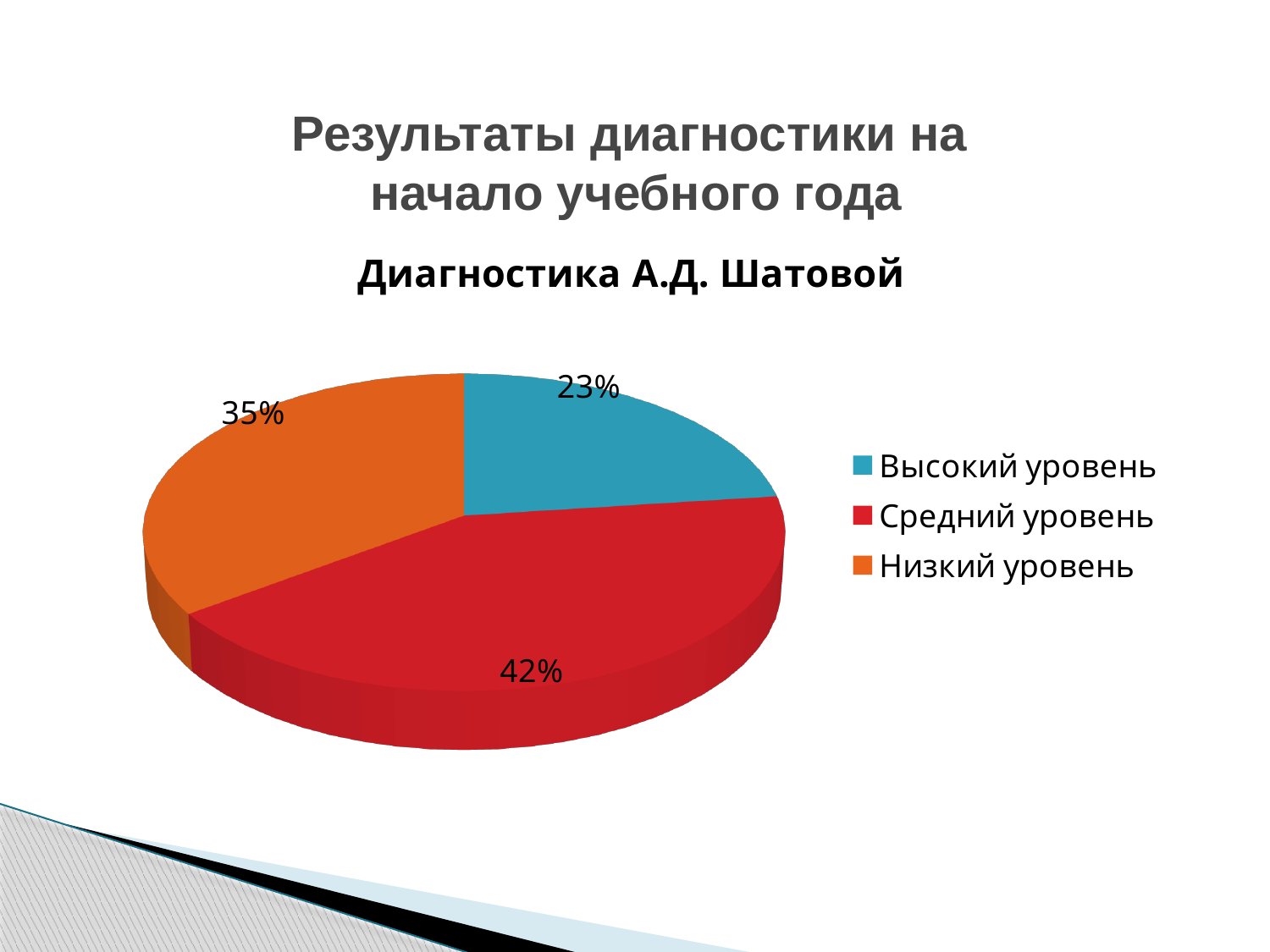
What percentage does the Низкий уровень slice show? 35% What percentage does the Средний уровень slice show? 42% What is the title of the chart? Диагностика А.Д. Шатовой How many entries does the legend list? 3 How many slices does the pie chart have? 3 Which is larger, the share for Низкий уровень or the share for Высокий уровень? Низкий уровень What is the difference in percentage points between Средний уровень and Высокий уровень? 19 What percentage does the Высокий уровень slice show? 23% What kind of chart is shown on the slide? Pie chart Which level has the smallest share of the pie? Высокий уровень Which level has the largest share of the pie? Средний уровень What is the difference in percentage points between Низкий уровень and Высокий уровень? 12